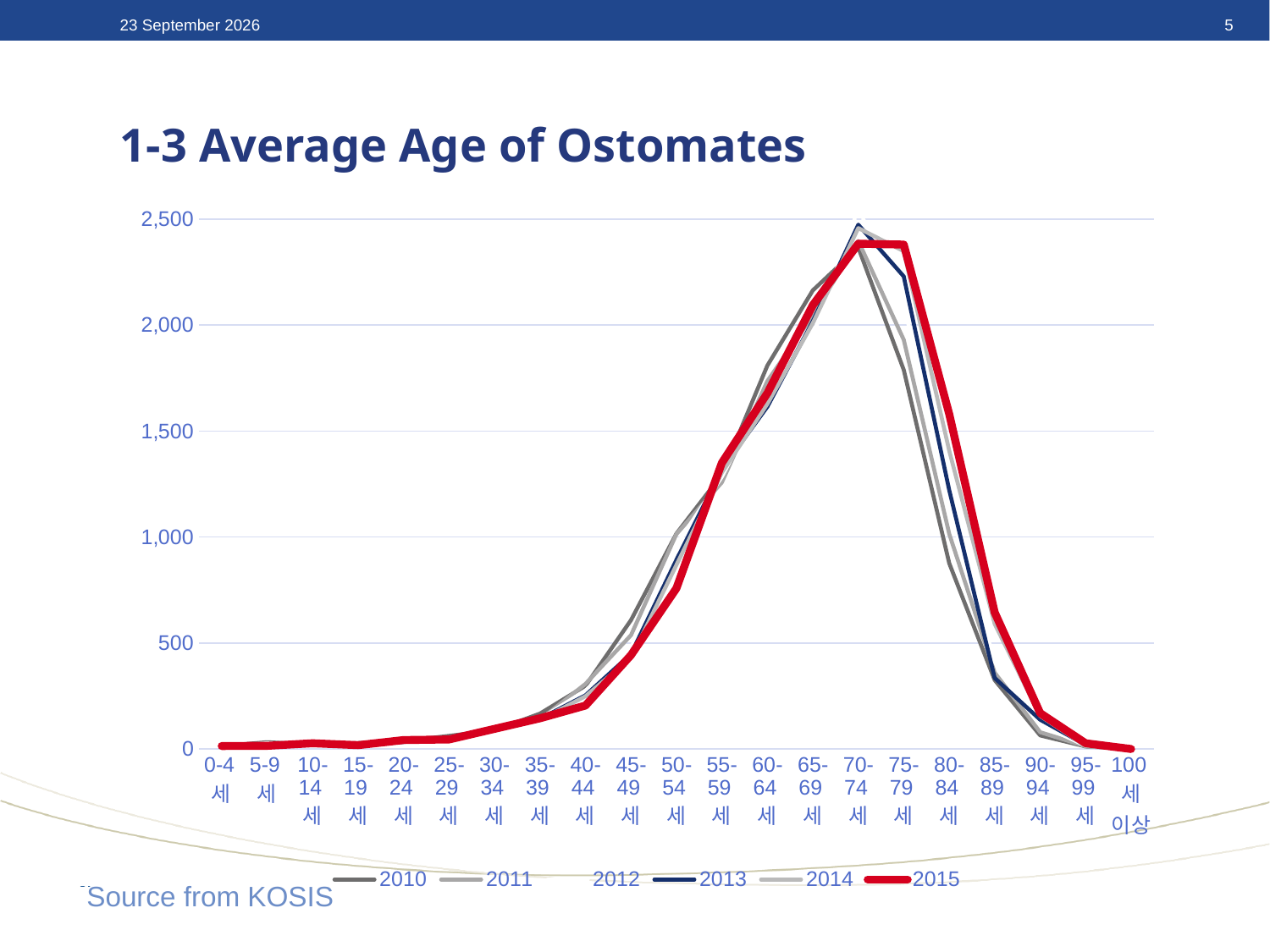
How many series does the legend list? 6 Is the 2015 value for the 60-64 age group greater or less than 1,500? greater Which series is drawn with the thick red line? 2015 Is the 2015 value for the 85-89 age group greater or less than 500? greater For the 2015 series, which is larger: the value for 75-79 or the value for 85-89? 75-79 What kind of chart is shown on the slide? line chart Is the 2015 value for the 40-44 age group greater or less than 500? less Do the 2015 values rise or fall from the 75-79 age group to the 95-99 age group? fall How many age categories are shown on the x axis? 21 For the 2013 series, which age group has the highest value? 70-74